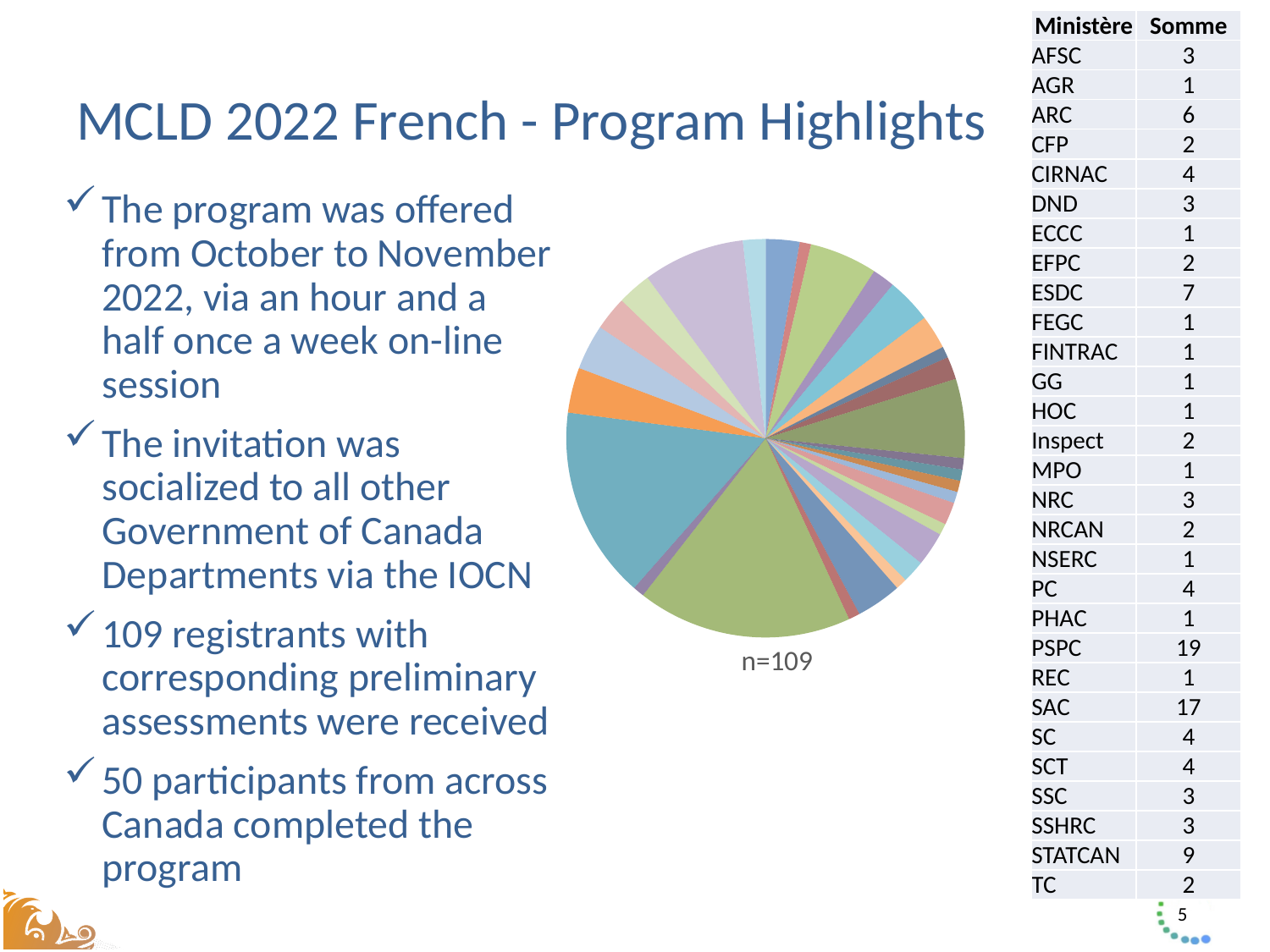
In the table next to the pie chart, which ministry has the highest value? PSPC In the table next to the pie chart, what is the value (Somme) for STATCAN? 9 What is the sample size noted below the pie chart? n=109 In the table next to the pie chart, what is the value (Somme) for SAC? 17 Does the pie chart have a legend identifying its slices? No In the table next to the pie chart, what is the difference between the values for PSPC and SAC? 2 In the table next to the pie chart, what is the value (Somme) for PSPC? 19 What kind of chart is shown on the slide? pie chart In the table next to the pie chart, what is the value (Somme) for CIRNAC? 4 In the table next to the pie chart, which is larger, the value for ESDC or the value for ARC? ESDC